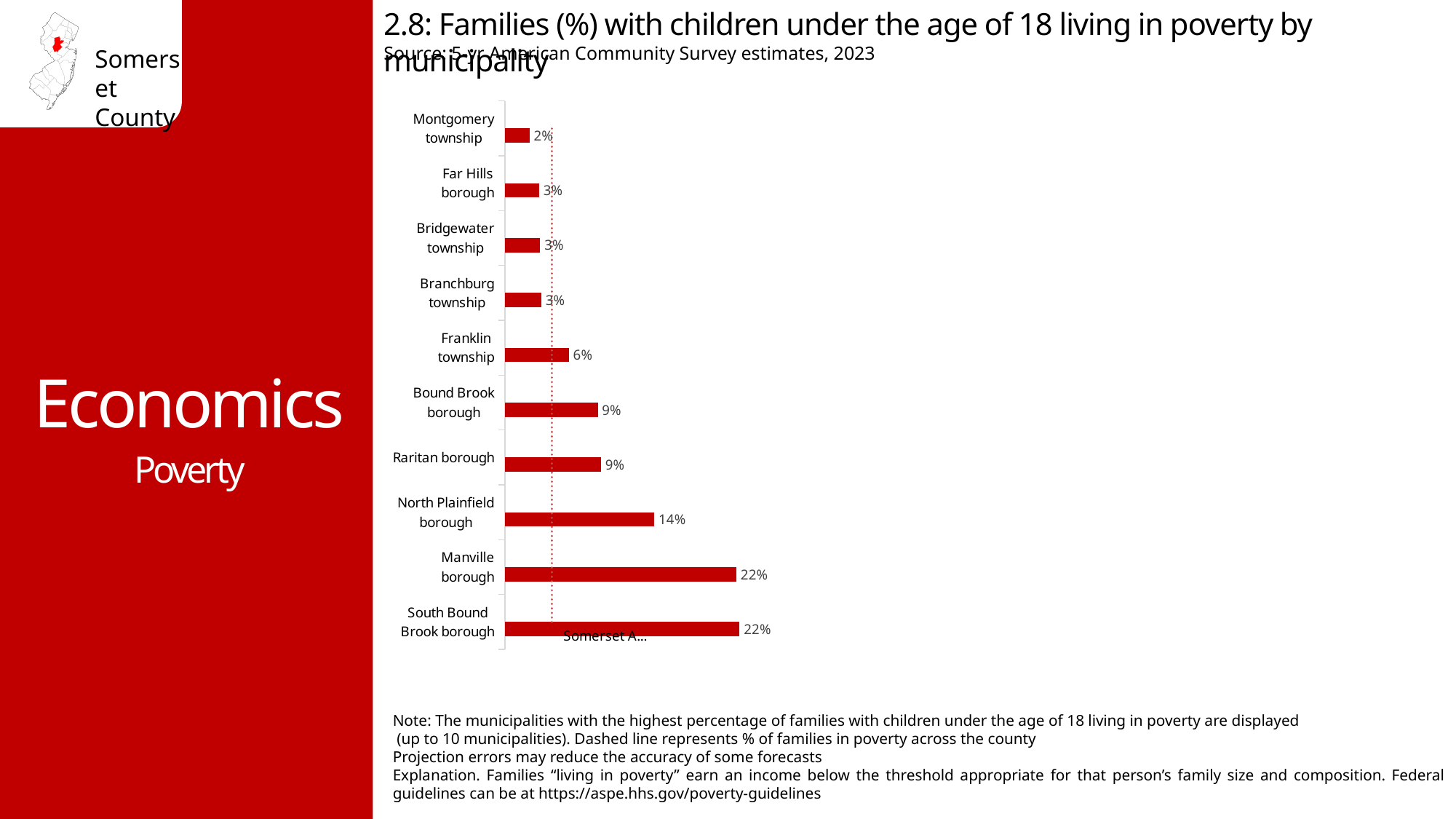
Which municipality has the lowest percentage of families with children under 18 living in poverty? Montgomery township What is the value shown for Bound Brook borough? 9% What does the dashed vertical line in the chart represent? % of families in poverty across the county What is the difference between the values for South Bound Brook borough and North Plainfield borough? 8% What is the value shown for Manville borough? 22% What percentage of families with children under 18 live in poverty in North Plainfield borough? 14% What type of chart is shown on the slide? bar chart What is the value shown for Franklin township? 6% How many municipalities are shown in the chart? 10 Which has a higher value, Raritan borough or Bridgewater township? Raritan borough Which has a higher value, North Plainfield borough or Manville borough? Manville borough What is the difference between the values for Franklin township and Montgomery township? 4%